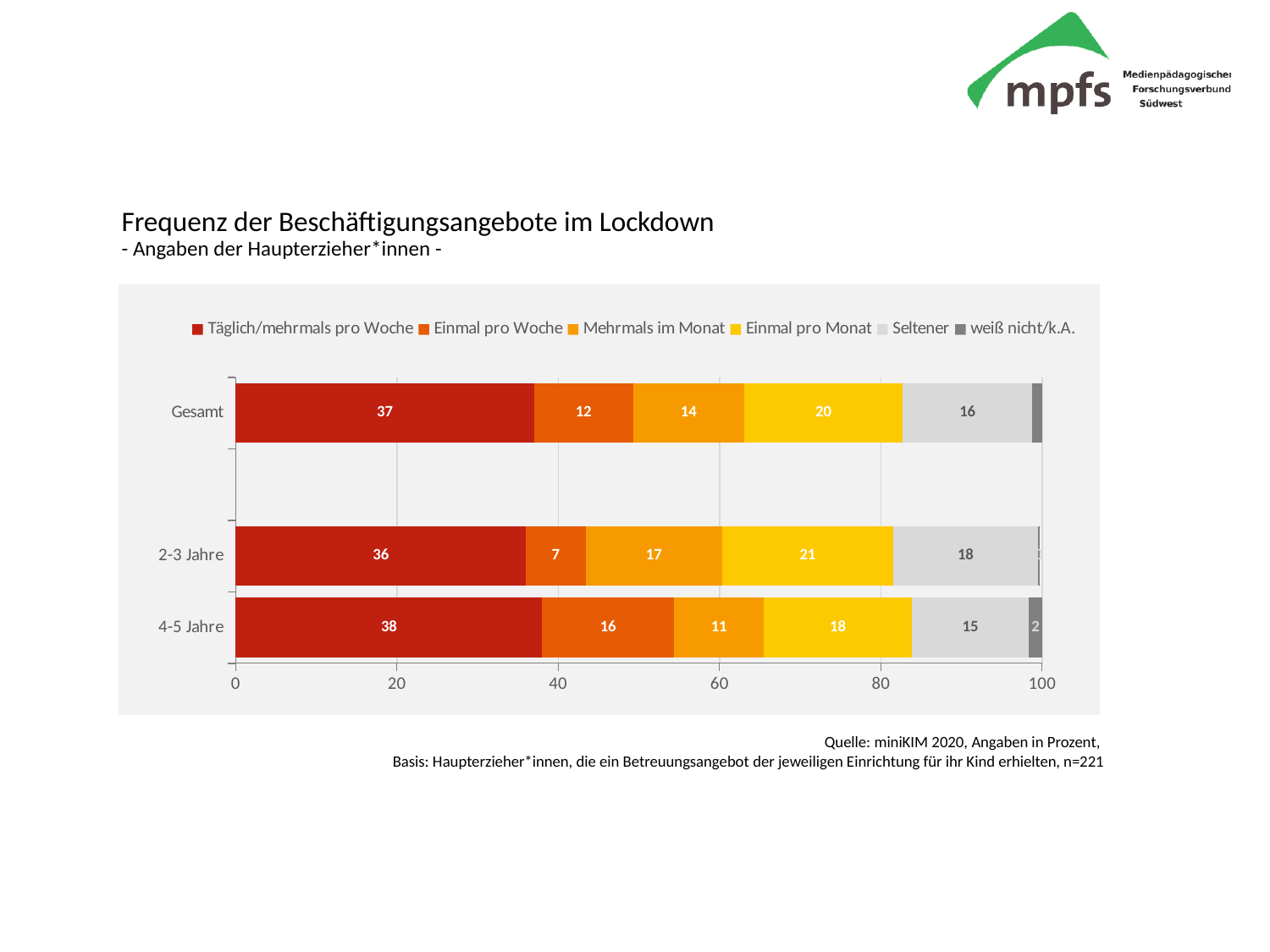
What is the value for "Seltener" in the 4-5 Jahre bar? 15 What is the difference between the "Einmal pro Monat" values for 2-3 Jahre and 4-5 Jahre? 3 How many categories (bars) are shown on the chart? 3 Which category has the highest value for "Täglich/mehrmals pro Woche"? 4-5 Jahre Which category has the lowest value for "Einmal pro Woche"? 2-3 Jahre How many series does the legend list? 6 Which category has the larger value for "Mehrmals im Monat": 2-3 Jahre or 4-5 Jahre? 2-3 Jahre What is the total of the 4-5 Jahre stacked bar? 100 What is the value for "Einmal pro Woche" in the 2-3 Jahre bar? 7 What kind of chart is shown on the slide? Stacked bar chart What is the value for "weiß nicht/k.A." in the 4-5 Jahre bar? 2 What is the value for "Täglich/mehrmals pro Woche" in the Gesamt bar? 37